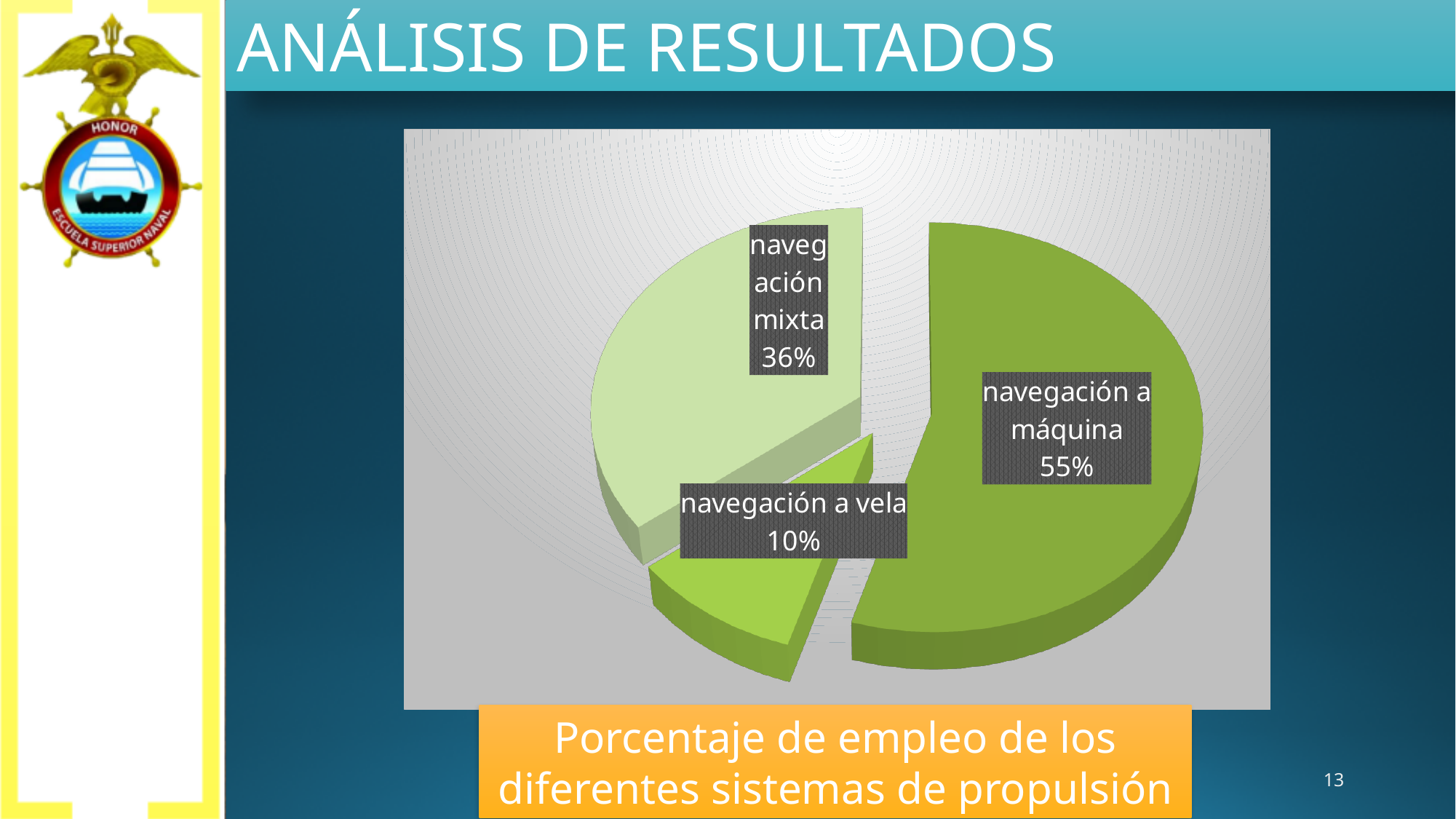
Which slice is shown in the lightest green colour? navegación mixta What kind of chart is shown on the slide? pie chart How many slices does the pie chart have? 3 What percentage does the 'navegación a vela' slice represent? 10% Which is larger, the share for 'navegación mixta' or the share for 'navegación a vela'? navegación mixta Which propulsion system has the largest share of the pie? navegación a máquina What is the difference in percentage points between 'navegación mixta' and 'navegación a vela'? 26 What is the caption shown below the chart? Porcentaje de empleo de los diferentes sistemas de propulsión What percentage does the 'navegación mixta' slice represent? 36% Which propulsion system has the smallest share of the pie? navegación a vela What is the difference in percentage points between 'navegación a máquina' and 'navegación mixta'? 19 What percentage does the 'navegación a máquina' slice represent? 55%